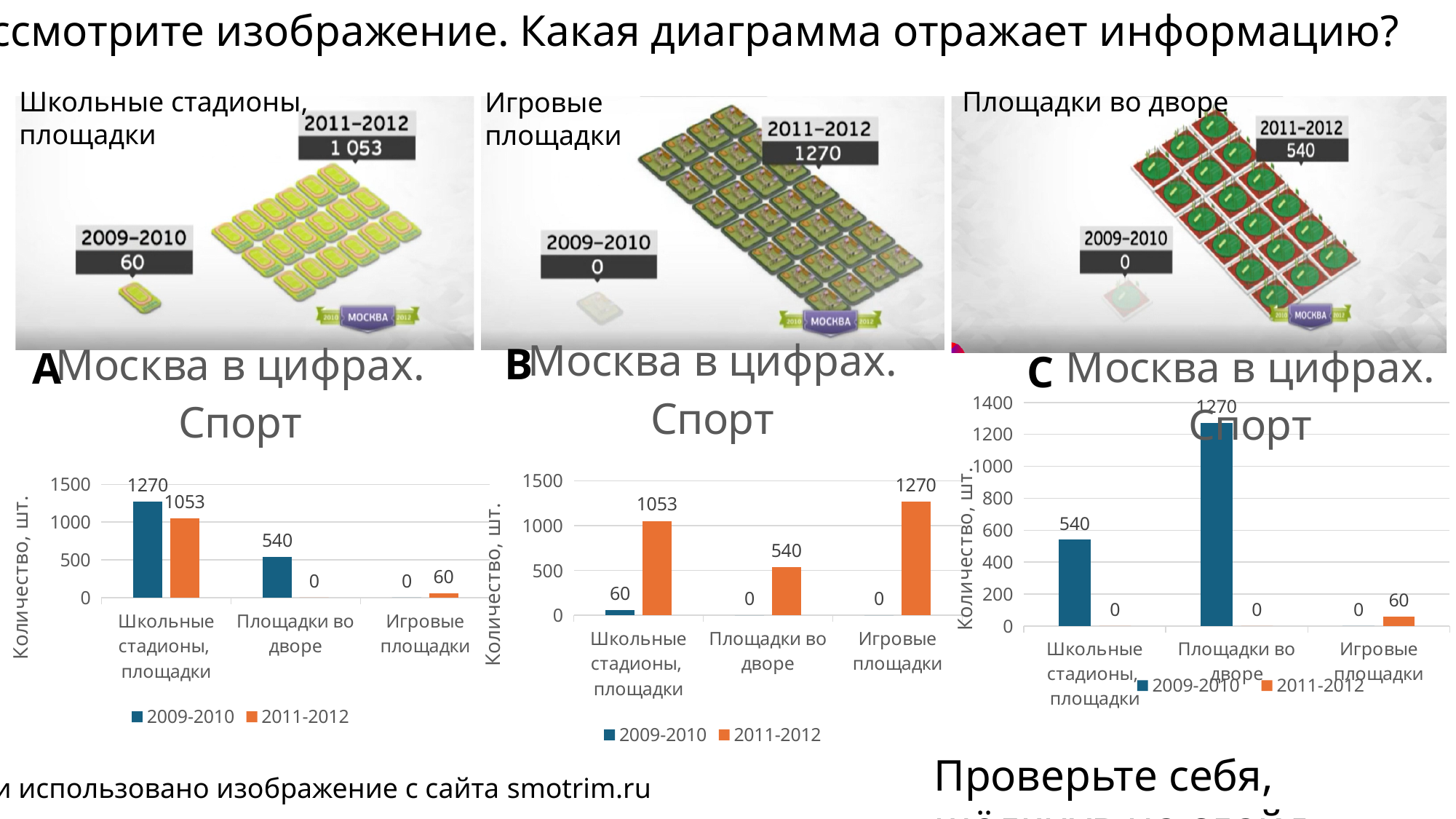
How many categories are shown on the x axis of chart B (the middle chart)? 3 What is the y-axis label of chart B (the middle chart)? Количество, шт. How many series does the legend of chart A (the left chart) list? 2 In chart C (the right chart), what is the value for Площадки во дворе in 2009-2010? 1270 In chart B (the middle chart), what is the difference between the 2011-2012 and 2009-2010 values for Школьные стадионы, площадки? 993 In chart B (the middle chart), what is the value for Игровые площадки in 2011-2012? 1270 What type of chart is chart C (the right chart)? Bar chart In chart C (the right chart), which is larger: the 2009-2010 value for Школьные стадионы, площадки or the 2009-2010 value for Площадки во дворе? Площадки во дворе In chart A (the left chart), which category has the lowest value for 2009-2010? Игровые площадки In chart A (the left chart), what is the value for Школьные стадионы, площадки in 2009-2010? 1270 In chart A (the left chart), is the 2011-2012 value for Школьные стадионы, площадки greater or less than 1000? greater In chart B (the middle chart), which category has the highest value for 2011-2012? Игровые площадки